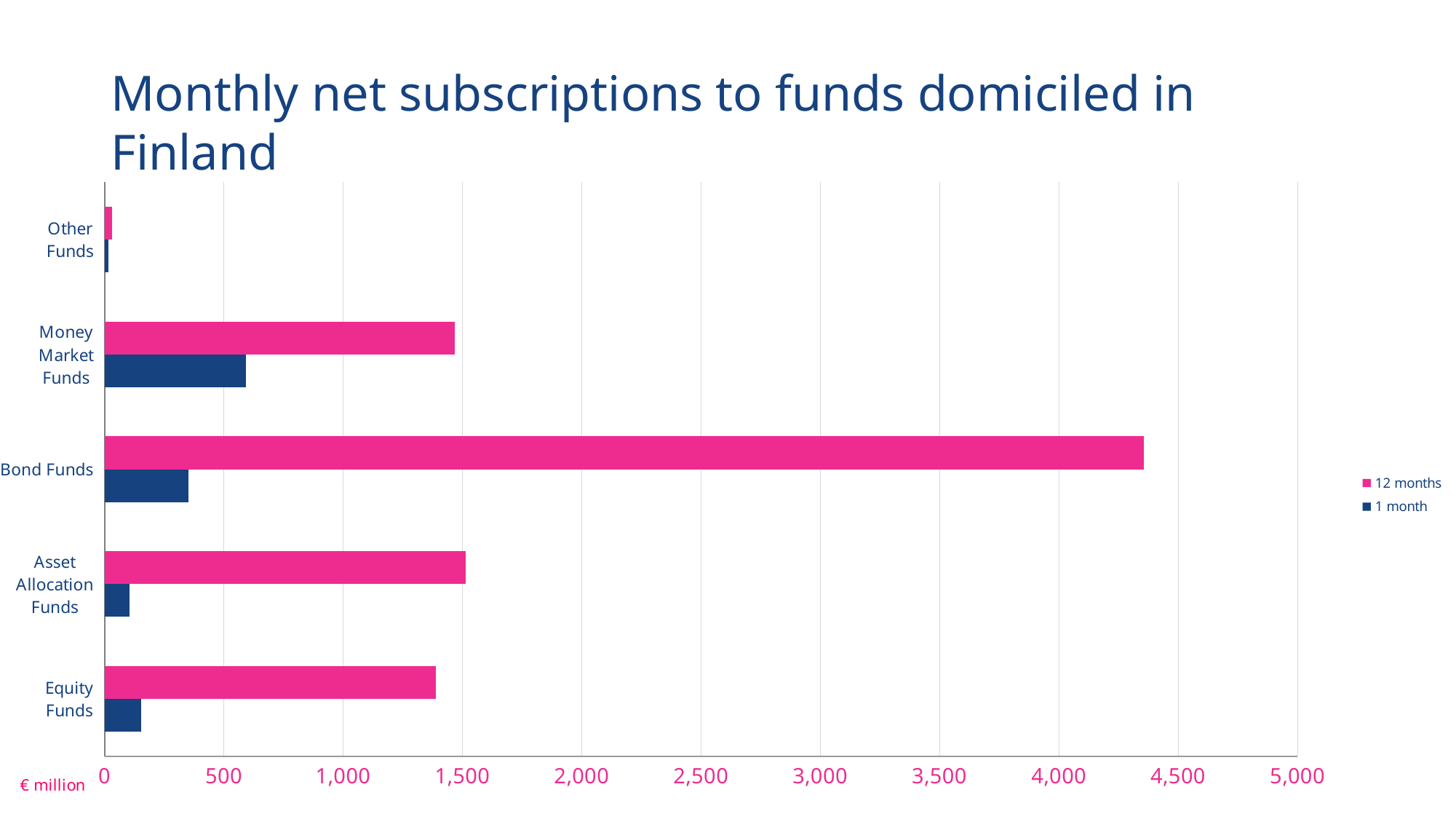
Which fund category has the highest 1 month value? Money Market Funds Is the 1 month value for Bond Funds greater or less than 500? less Which fund category has the lowest 12 months value? Other Funds What unit is shown for the x axis of the chart? € million Which fund category has the highest 12 months value? Bond Funds How many fund categories are shown on the chart? 5 How many series does the legend list? 2 Is the 12 months value for Bond Funds greater or less than 4,000? greater Is the 12 months value for Equity Funds greater or less than 1,500? less Which is larger: the 1 month value for Money Market Funds or the 1 month value for Bond Funds? Money Market Funds What kind of chart is shown on the slide? bar chart